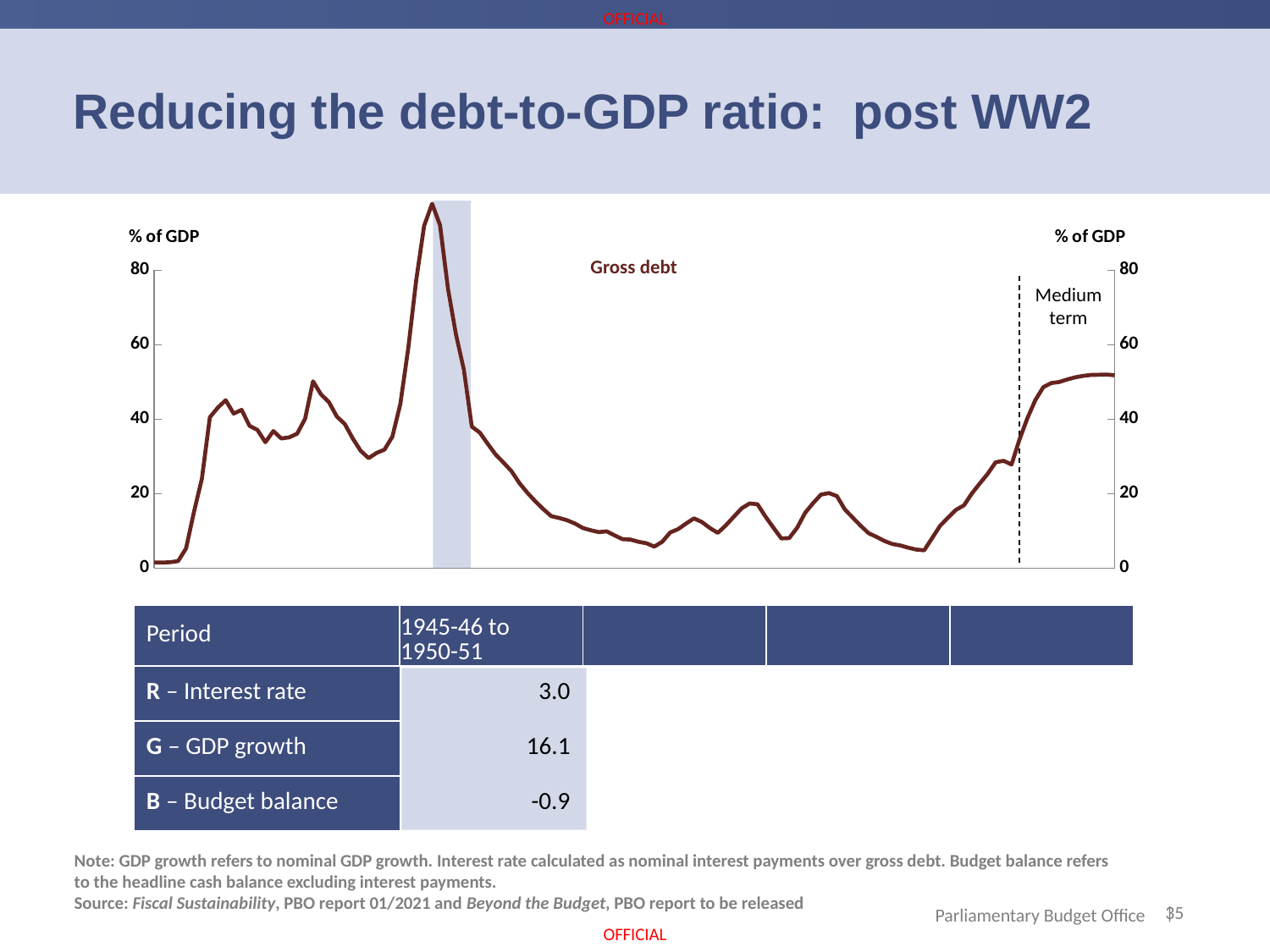
What kind of chart is shown on the slide? Line chart To the right of the dashed vertical line, does the gross debt line rise or fall overall? rise Is the value of gross debt at the far left start of the chart greater or less than 20? less What series is plotted on the chart? Gross debt Is the peak value of gross debt on the chart greater or less than 80? greater How many series are plotted on the chart? 1 Immediately after the peak, does the gross debt line rise or fall? fall Is the value of gross debt at the far right end of the chart greater or less than 40? greater What unit is shown on the vertical axes of the chart? % of GDP What label is placed next to the dashed vertical line on the chart? Medium term